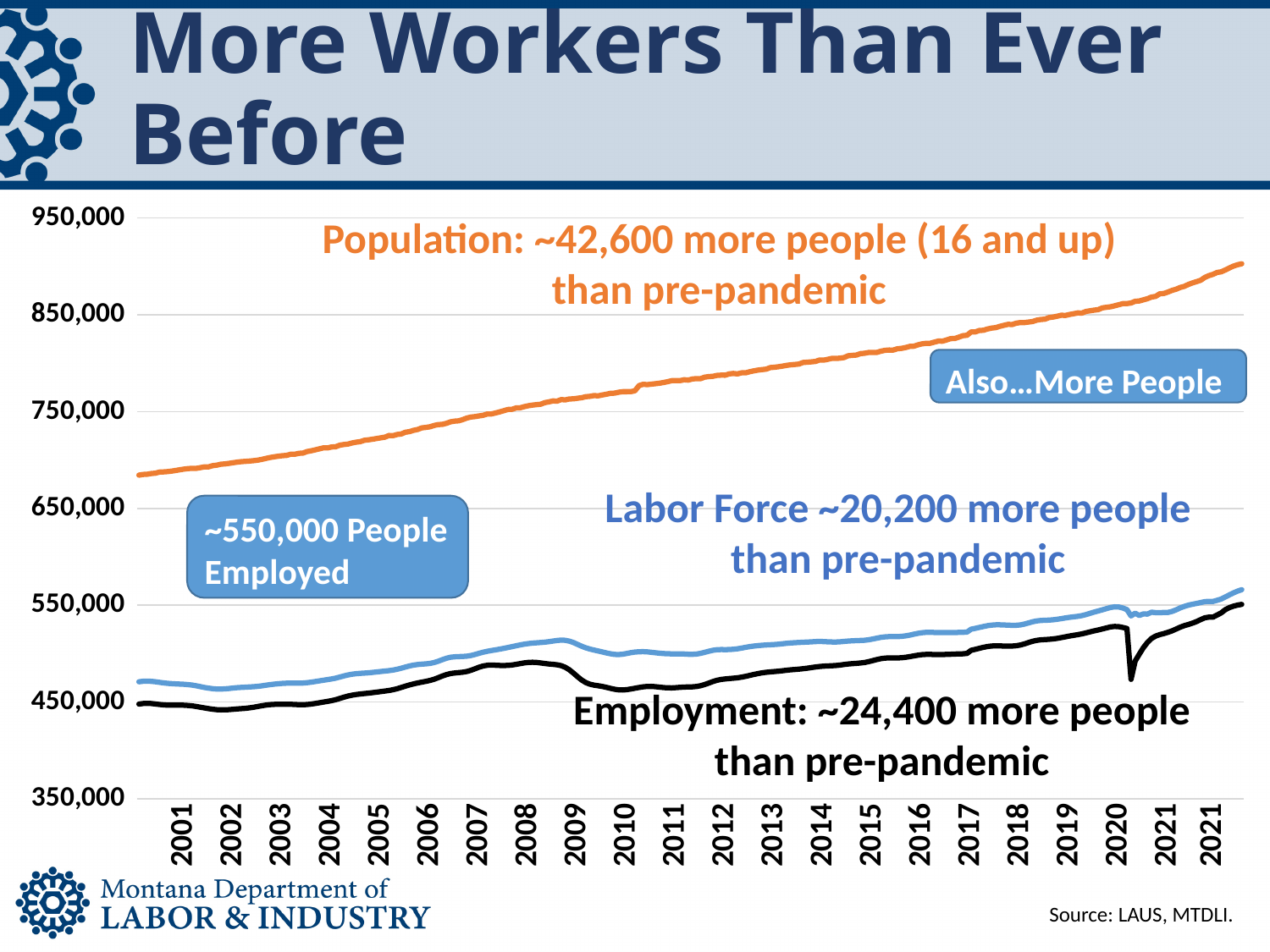
Is the Population value in 2001 greater or less than 650,000? greater Does the Population line rise or fall from 2001 to 2021? rise How many lines (series) are plotted on the chart? 3 What is the first year shown on the x axis? 2001 Is the Labor Force value in 2001 greater or less than 550,000? less Is the Population value at the end of 2021 greater or less than 850,000? greater What kind of chart is shown on the slide? line chart Which series is plotted lowest on the chart? Employment Which is larger in 2010, the Labor Force value or the Employment value? Labor Force Which series is plotted highest on the chart? Population